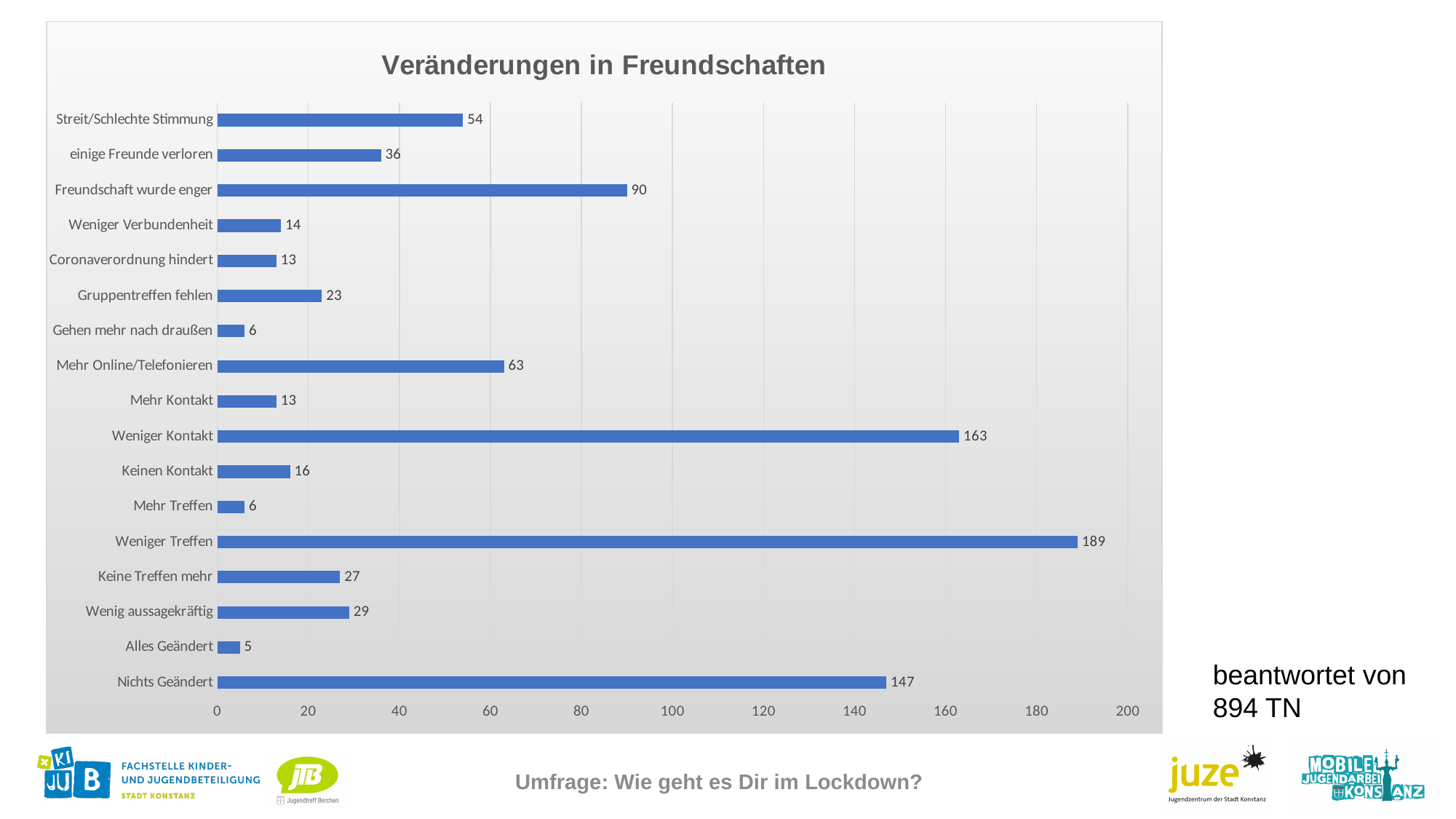
What kind of chart is shown on the slide? Bar chart What is the value for "Mehr Online/Telefonieren"? 63 Which category has the lowest value? Alles Geändert What is the difference between "Weniger Treffen" and "Weniger Kontakt"? 26 What is the value for "Weniger Treffen"? 189 Is the value for "Weniger Kontakt" greater or less than 140? greater What is the title of the chart? Veränderungen in Freundschaften How many categories are shown in the chart? 17 What is the value for "Freundschaft wurde enger"? 90 Which category has the highest value? Weniger Treffen What is the difference between "Weniger Kontakt" and "Nichts Geändert"? 16 Which is larger, "Streit/Schlechte Stimmung" or "einige Freunde verloren"? Streit/Schlechte Stimmung